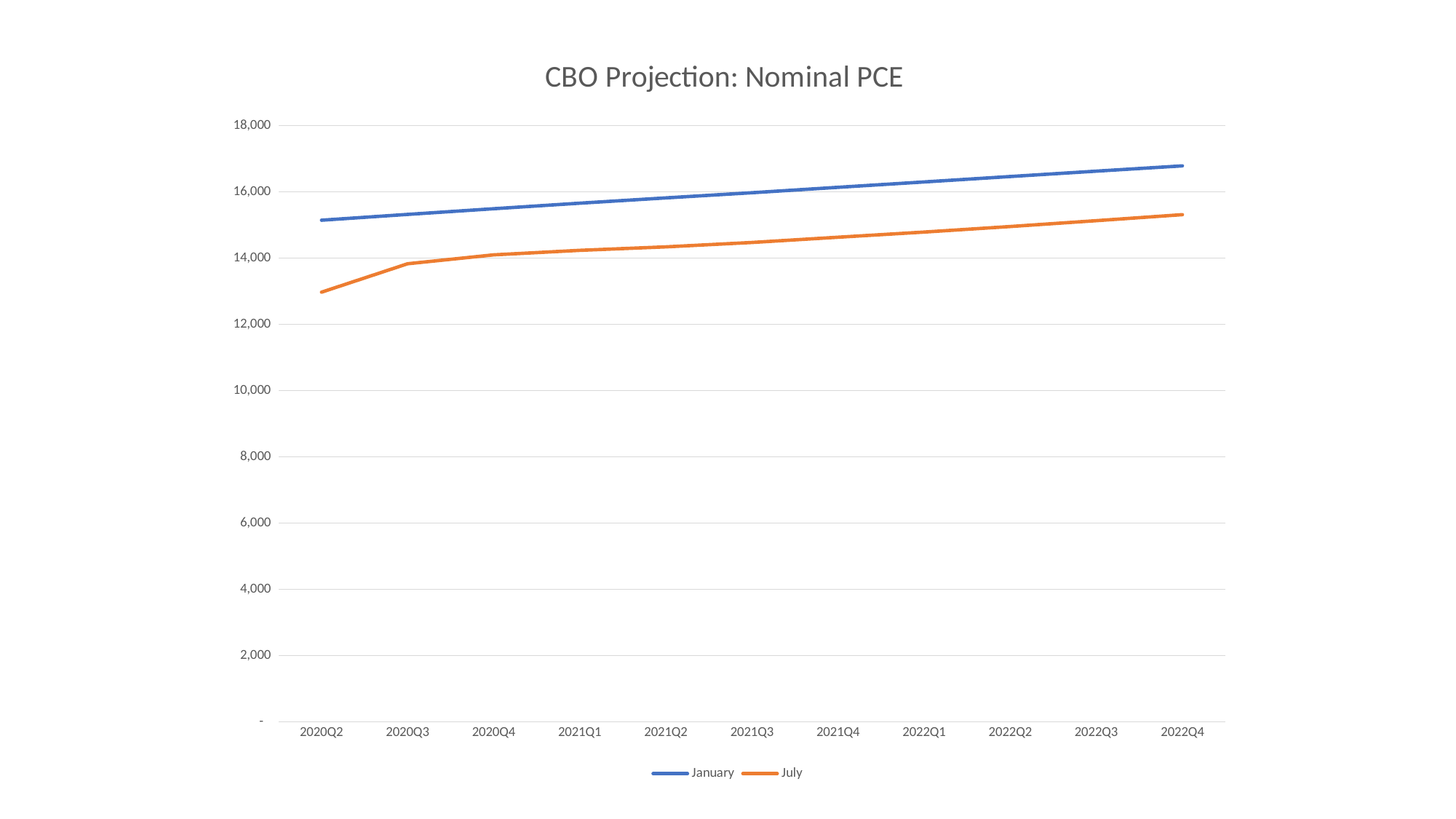
At which quarter is the January series highest? 2022Q4 At which quarter is the July series lowest? 2020Q2 Which series is higher at 2020Q2, January or July? January How many series does the legend list? 2 What kind of chart is shown on the slide? line chart How many quarters are shown on the x axis? 11 Is the January value for 2022Q4 greater or less than 16,000? greater What is the title of the chart? CBO Projection: Nominal PCE Is the July value for 2020Q2 greater or less than 14,000? less Does the January series rise or fall across the quarters shown? rise Does the July series rise or fall from 2020Q2 to 2022Q4? rise Is the July value for 2022Q4 greater or less than 16,000? less